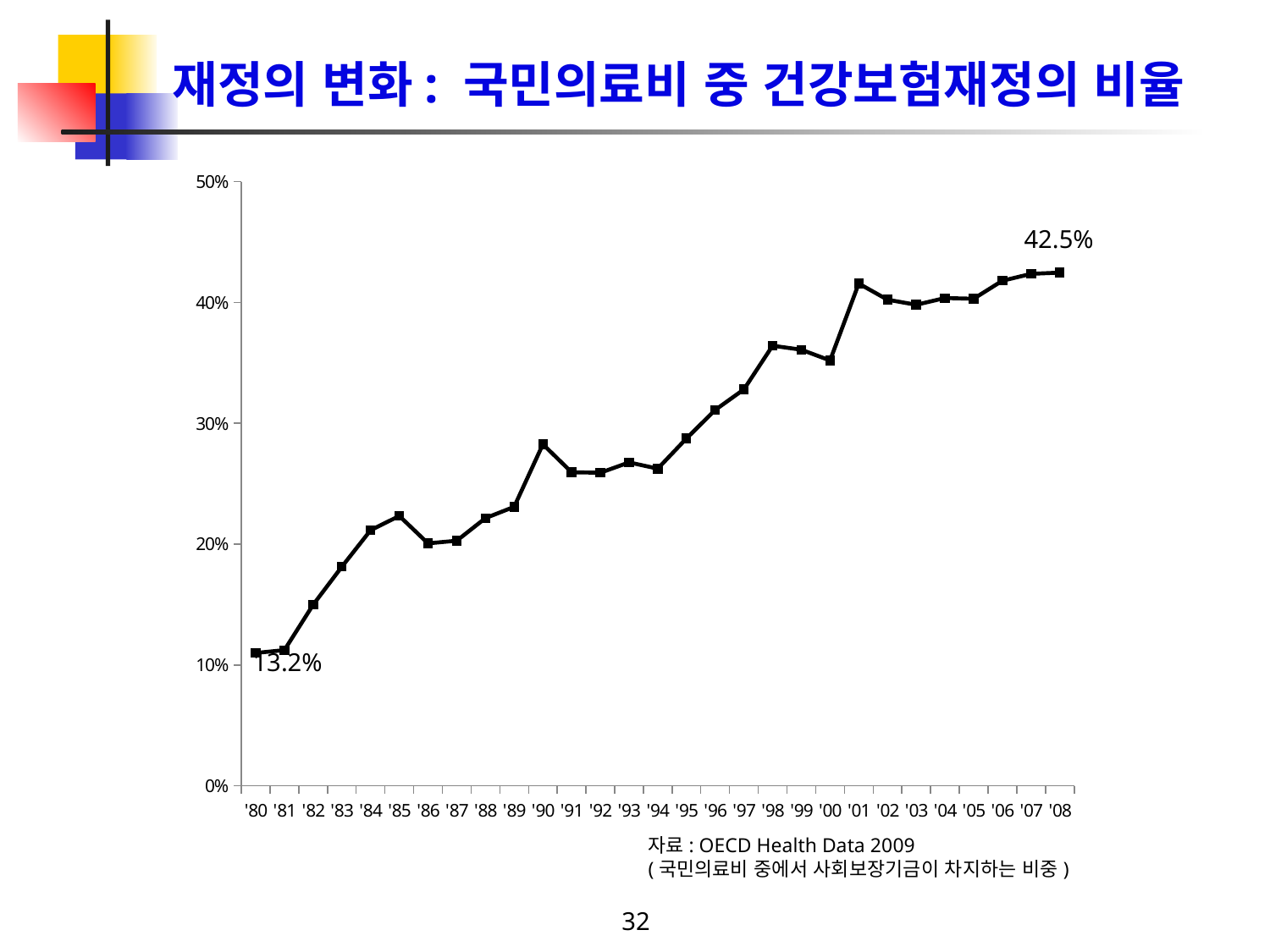
Is the value for '01 greater or less than 40%? greater What is the value shown for '08? 42.5% Which year has the higher value, '90 or '91? '90 Is the value for '90 greater or less than 30%? less What kind of chart is shown on the slide? line chart What data source is cited below the chart? OECD Health Data 2009 Is the value for '98 greater or less than 30%? greater How many years (data points) are plotted along the x axis? 29 Overall, do the values rise or fall from '80 to '08? rise Which year has the higher value, '00 or '01? '01 What data label is printed near the start of the line, at the left of the chart? 13.2%